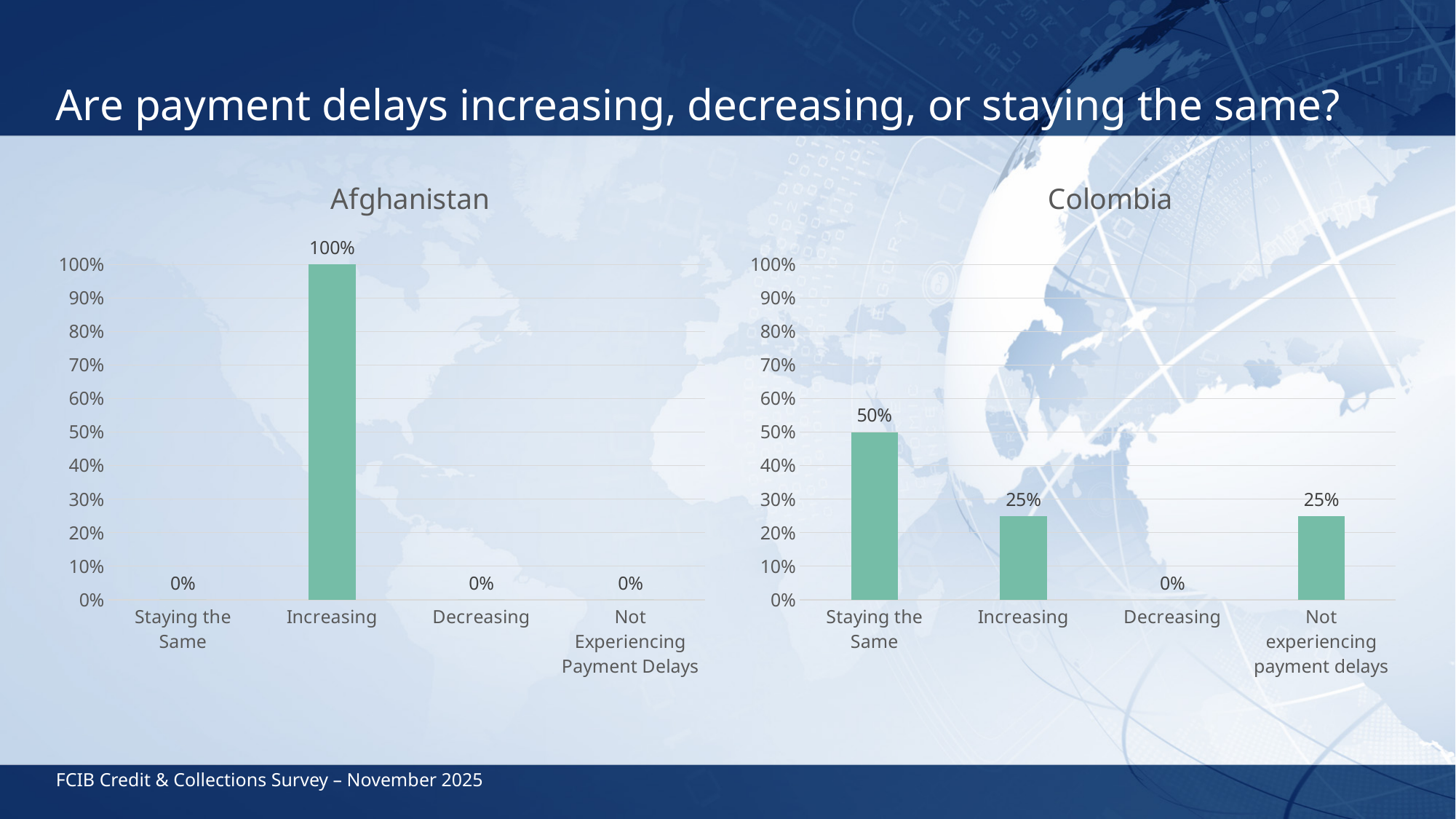
In the Afghanistan chart, which category has the highest value? Increasing In the Colombia chart, what is the value for Staying the Same? 50% In the Colombia chart, which category has the highest value? Staying the Same What is the title of the chart on the left side of the slide? Afghanistan In the Colombia chart, which category has the lowest value? Decreasing What kind of chart is the Colombia chart? Bar chart In the Afghanistan chart, what is the value for Increasing? 100% In the Colombia chart, what is the value for Not experiencing payment delays? 25% In the Colombia chart, which is larger, Staying the Same or Increasing? Staying the Same How many categories are shown in the Afghanistan chart? 4 In the Colombia chart, what is the difference between Staying the Same and Increasing? 25% In the Afghanistan chart, what is the value for Decreasing? 0%